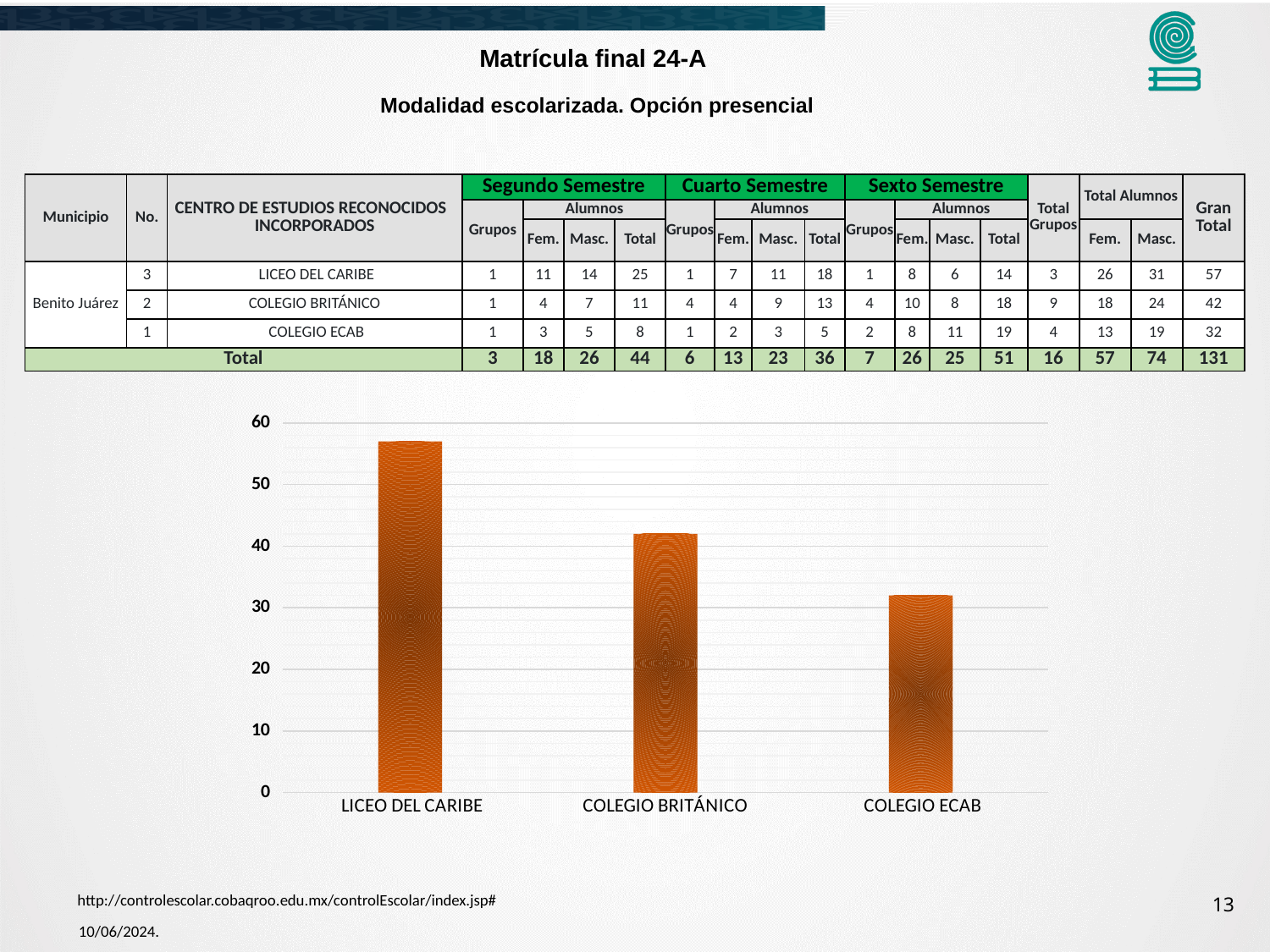
What colour are the bars in the chart? orange Is the value for COLEGIO ECAB greater or less than 40? less Is the value for COLEGIO ECAB greater or less than 30? greater What is the highest value shown on the chart's vertical axis? 60 Which category has the highest bar in the chart? LICEO DEL CARIBE Do the bar values rise or fall from left to right along the x axis? fall Is the value for COLEGIO BRITÁNICO greater or less than 40? greater Which is larger, the bar for COLEGIO BRITÁNICO or the bar for COLEGIO ECAB? COLEGIO BRITÁNICO How many categories are plotted in the bar chart? 3 Which category has the lowest bar in the chart? COLEGIO ECAB What kind of chart is shown on the slide? bar chart